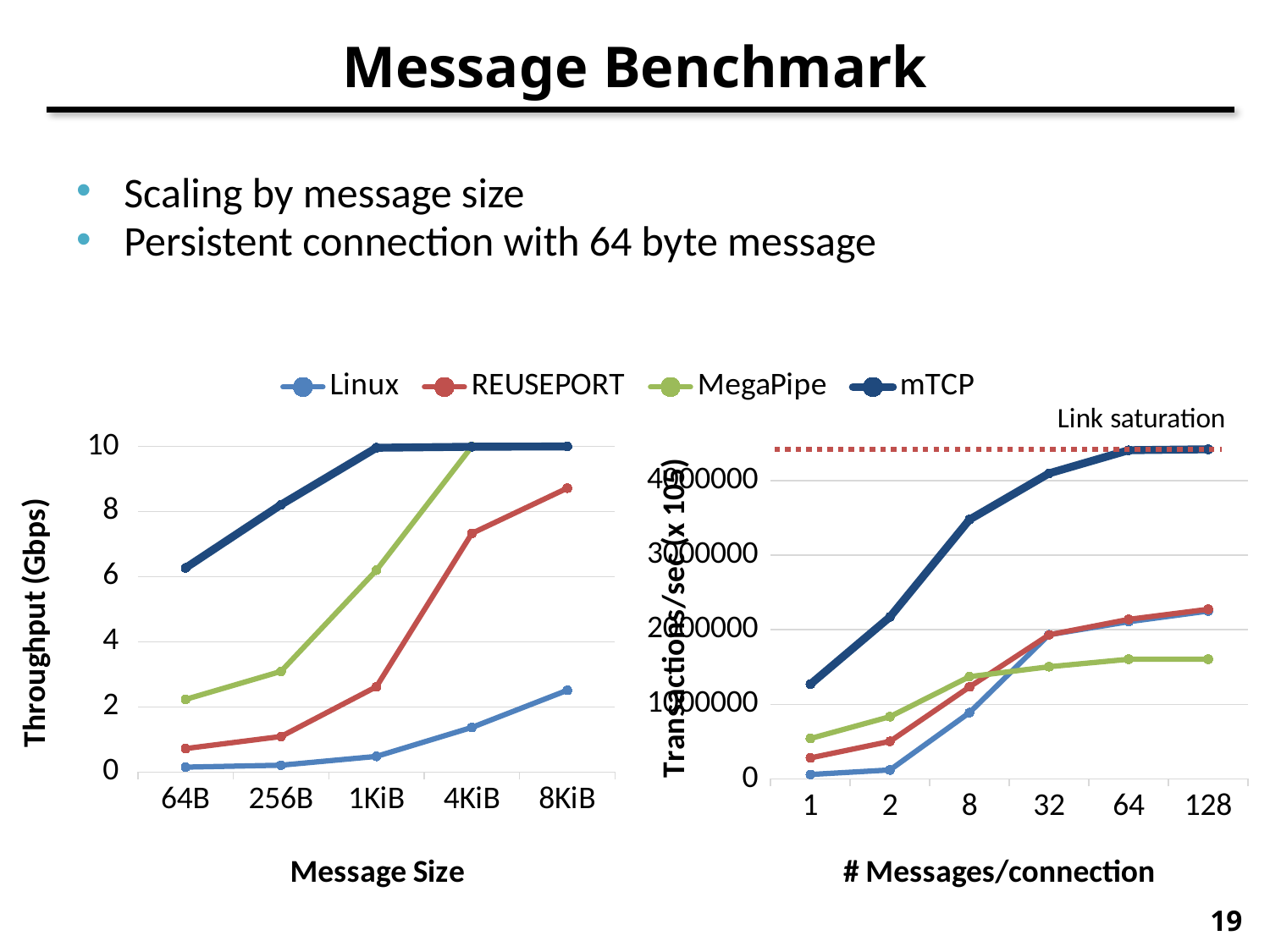
In the right chart (# Messages/connection), which series has the lowest value at 128 messages per connection? MegaPipe In the right chart (# Messages/connection), is the mTCP value at 8 messages per connection greater or less than 3000000? greater What kind of chart is the left chart (Throughput vs Message Size)? line chart In the left chart (Message Size), is the Linux value at 8KiB greater or less than 2? greater In the right chart (# Messages/connection), how many categories are on the x axis? 6 In the left chart (Message Size), is the REUSEPORT value at 8KiB greater or less than 8? greater In the left chart (Message Size), which series has the lowest throughput at 8KiB? Linux How many series does the legend list? 4 In the right chart (# Messages/connection), does the Linux series rise or fall as the number of messages per connection increases? rise In the left chart (Message Size), which is larger at 1KiB: MegaPipe or REUSEPORT? MegaPipe In the left chart (Message Size), which series has the highest throughput at 64B? mTCP In the left chart (Message Size), how many message size categories are on the x axis? 5